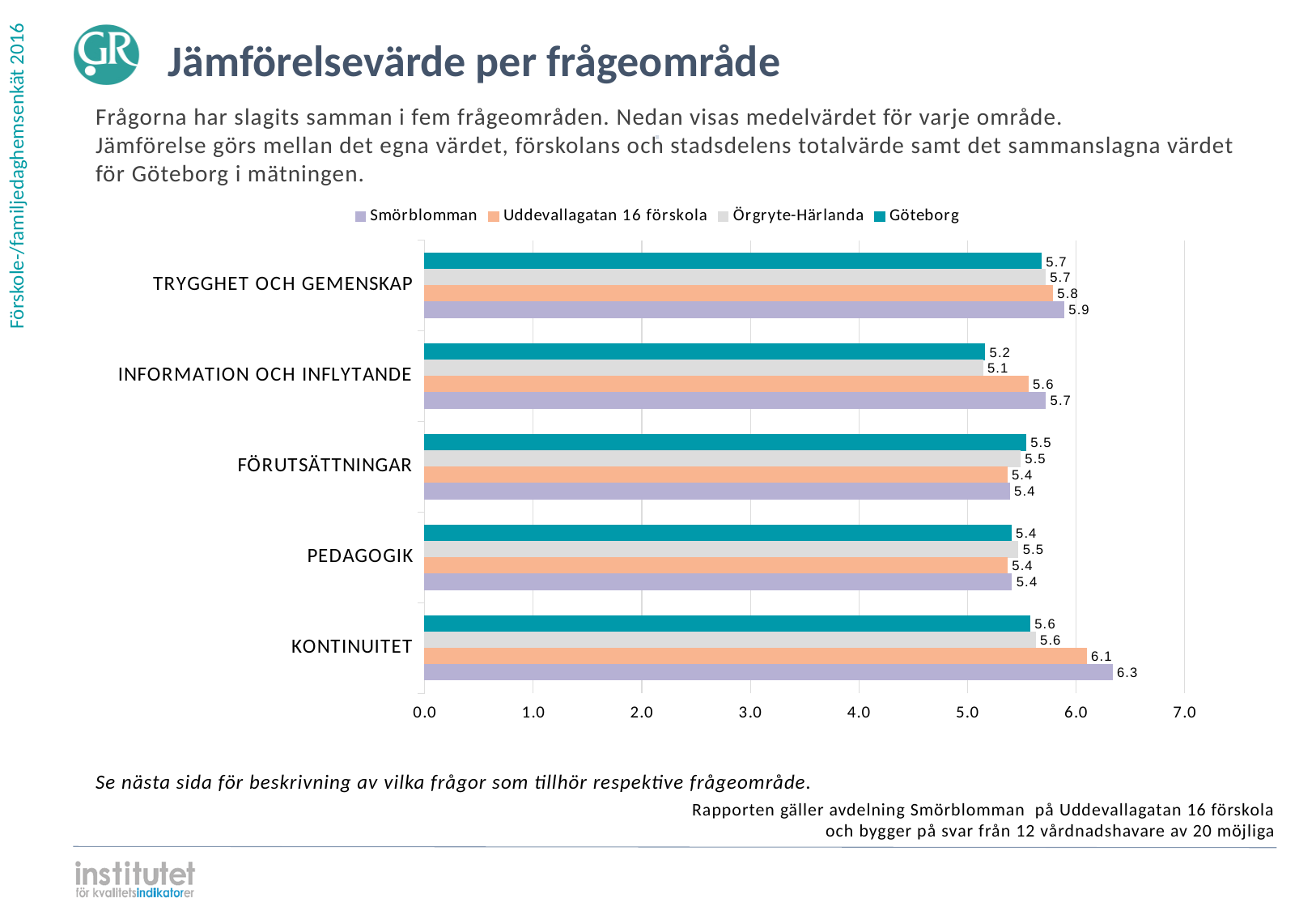
What is the value for Göteborg in the INFORMATION OCH INFLYTANDE category? 5.2 What is the difference between the Smörblomman and Göteborg values in the KONTINUITET category? 0.7 In the INFORMATION OCH INFLYTANDE category, which is larger: the value for Smörblomman or the value for Örgryte-Härlanda? Smörblomman What is the value for Uddevallagatan 16 förskola in the TRYGGHET OCH GEMENSKAP category? 5.8 What is the value for Örgryte-Härlanda in the PEDAGOGIK category? 5.5 What is the value for Smörblomman in the KONTINUITET category? 6.3 How many categories are shown on the chart? 5 In which category does Örgryte-Härlanda have its lowest value? INFORMATION OCH INFLYTANDE How many series does the legend list? 4 What kind of chart is shown on the slide? Bar chart Which series is shown in teal on the chart? Göteborg In which category does Smörblomman have its highest value? KONTINUITET